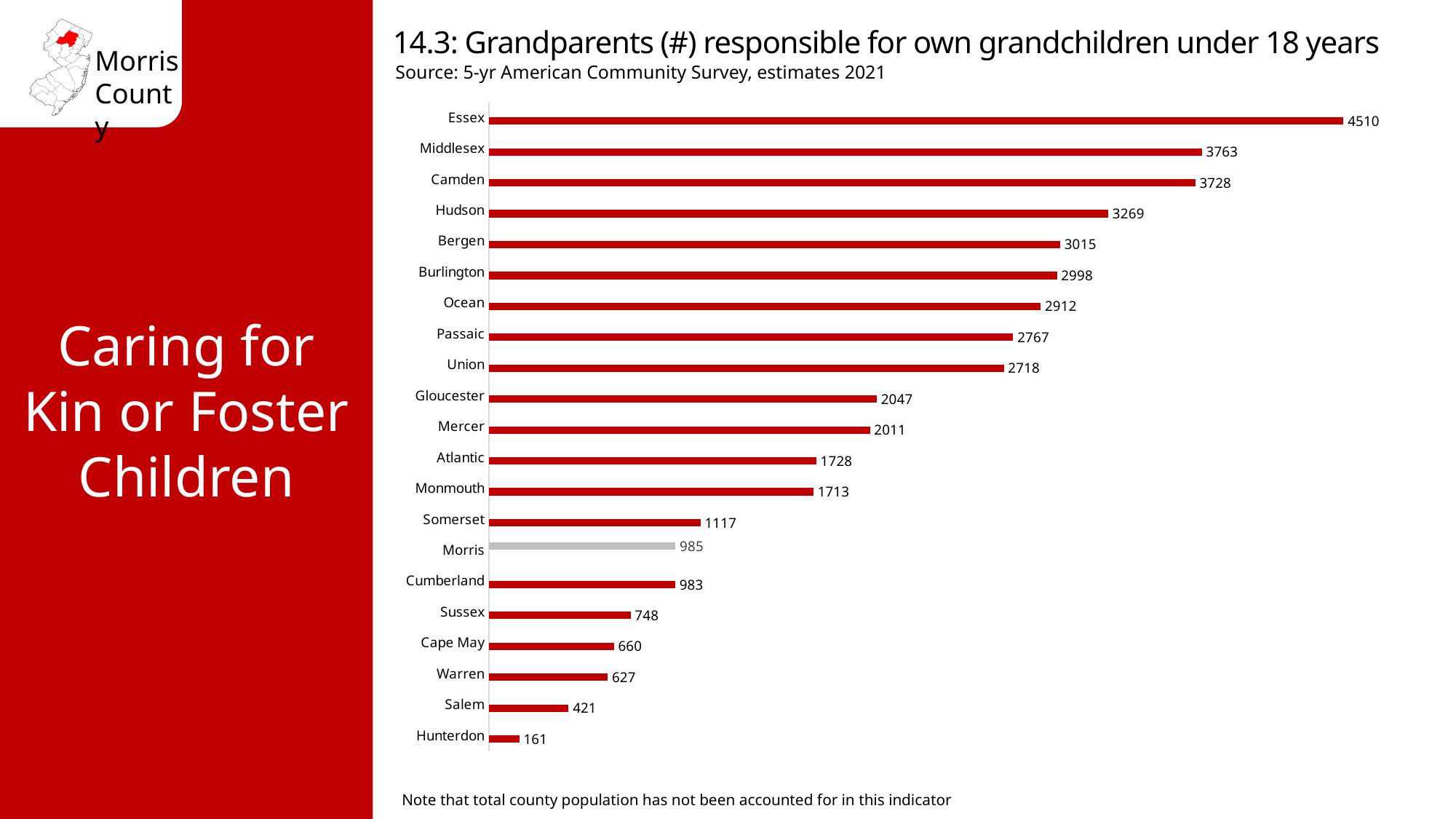
What is the value shown for Cape May? 660 What is the number of grandparents responsible for own grandchildren in Morris County? 985 How many counties are shown on the chart? 21 Which has a larger value, Sussex or Warren? Sussex What is the difference between the values for Essex and Middlesex? 747 Which county has the highest number of grandparents responsible for own grandchildren? Essex What kind of chart is shown on the slide? Bar chart What is the difference between the values for Morris and Cumberland? 2 Which county's bar is coloured grey instead of red? Morris What is the value shown for Hudson? 3269 Which county has the lowest value on the chart? Hunterdon Which has a larger value, Gloucester or Mercer? Gloucester